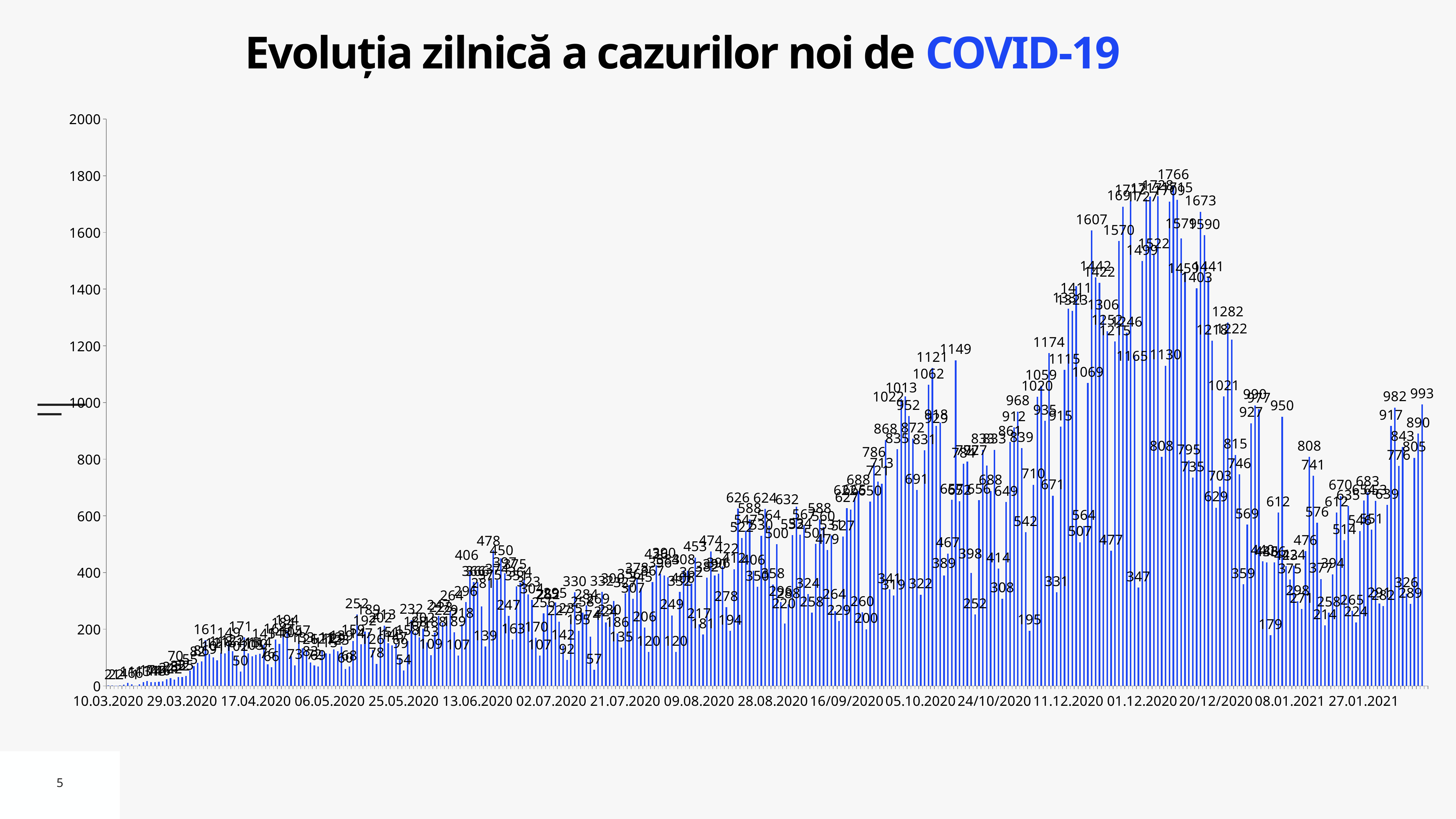
What is the highest value shown on the vertical axis? 2000 Is the highest value on the chart greater or less than 1600? greater Is the highest value on the chart greater or less than 1800? less Does any bar on the chart reach 2000? No What is the first date label on the horizontal axis? 10.03.2020 Do the daily values generally rise or fall between 10.03.2020 and 01.12.2020? rise What is the title of the chart? Evoluția zilnică a cazurilor noi de COVID-19 How many date labels are shown on the horizontal axis? 18 Do the daily values generally rise or fall between 01.12.2020 and 08.01.2021? fall What kind of chart is shown on the slide? bar chart What is the highest daily value labelled on the chart? 1766 What is the last date label on the horizontal axis? 27.01.2021